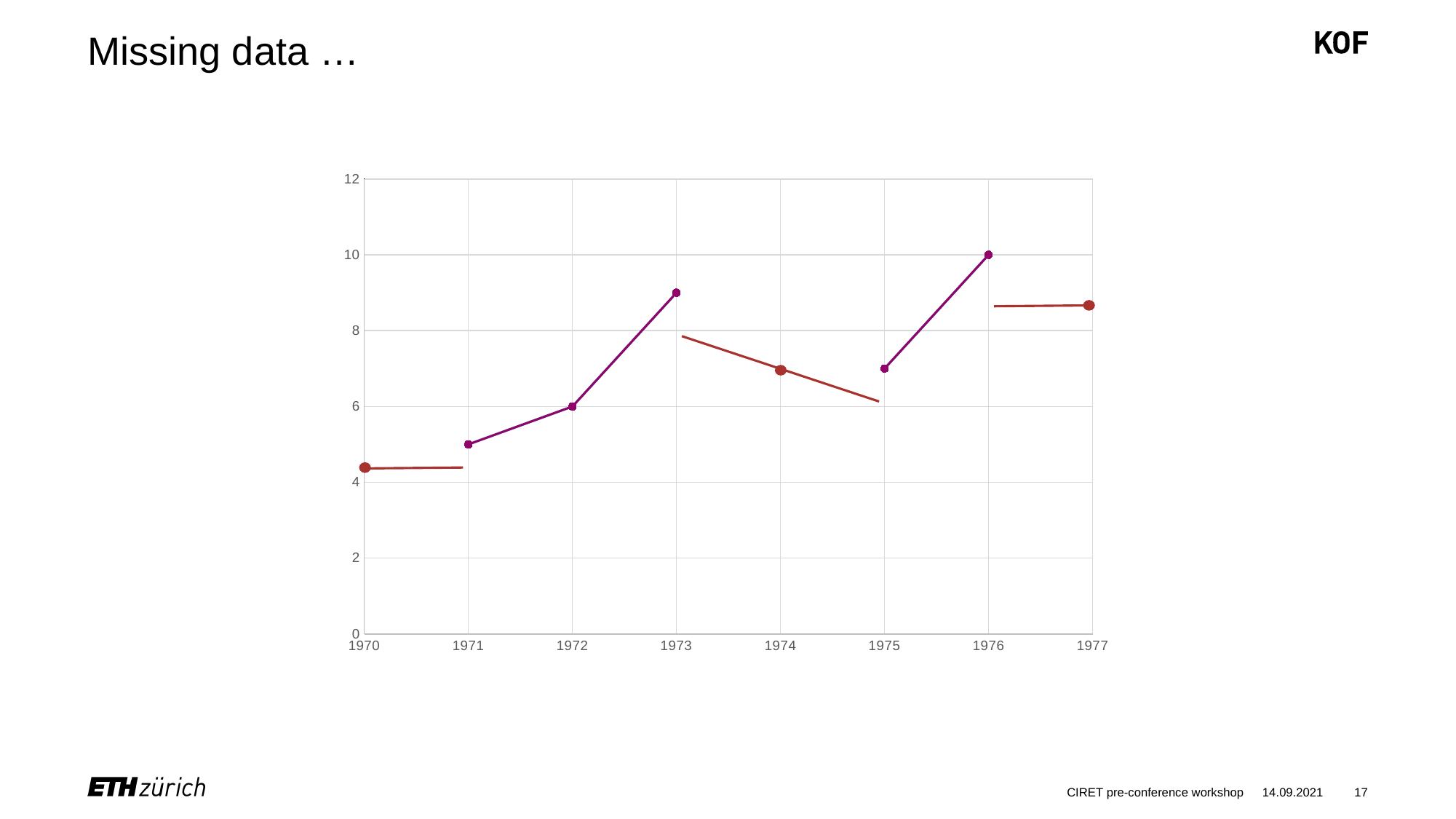
What kind of chart is shown on the slide? line chart What is the value plotted for 1976? 10 What is the value plotted for 1972? 6 Which year has the highest plotted value? 1976 Which year has the larger value, 1973 or 1975? 1973 Do the values rise or fall from 1971 to 1973? rise